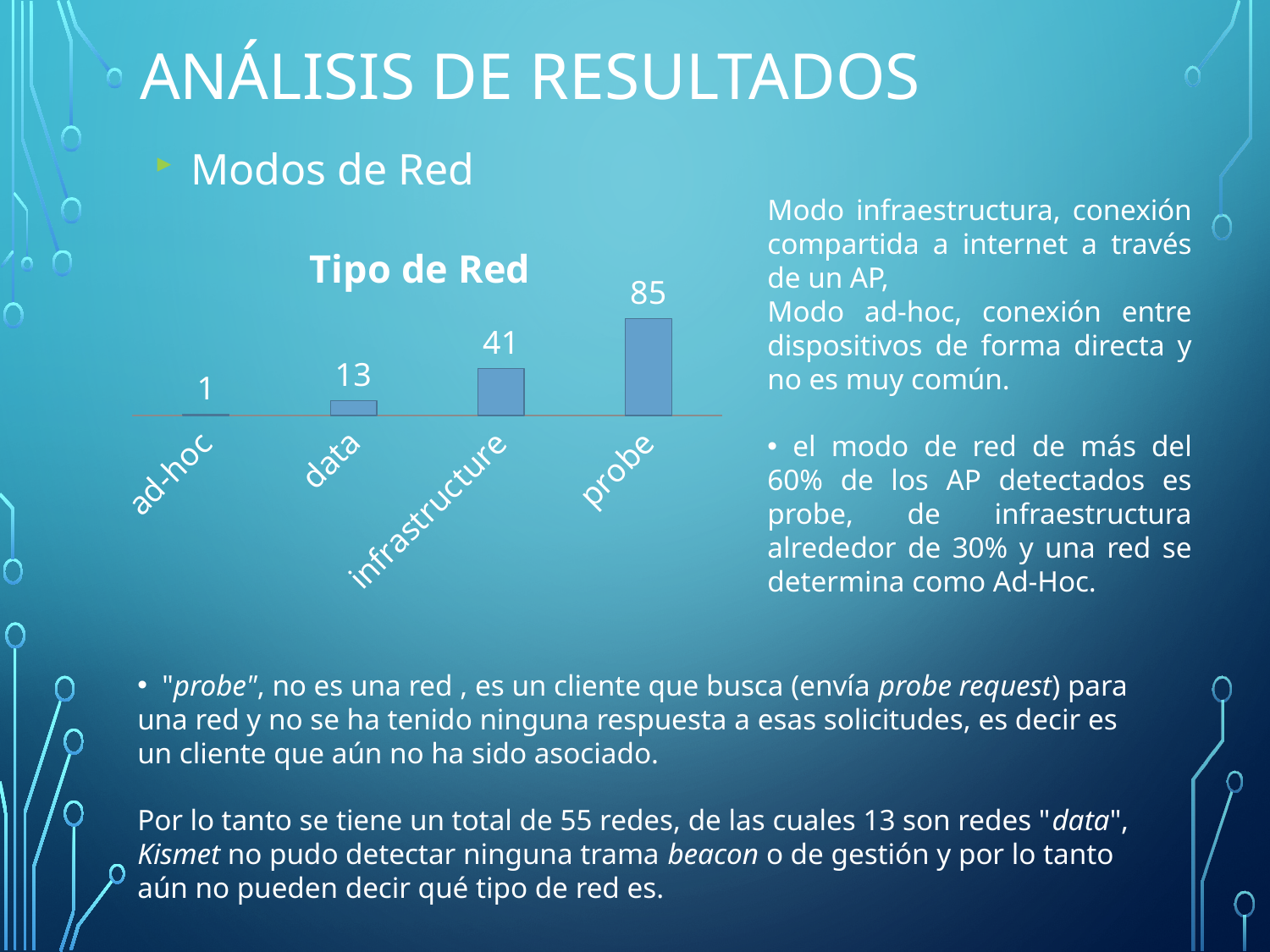
Which category has the highest value in the Tipo de Red chart? probe What is the value for infrastructure in the Tipo de Red chart? 41 What is the value for ad-hoc in the Tipo de Red chart? 1 What is the difference between the values for infrastructure and data in the Tipo de Red chart? 28 Which category has the lowest value in the Tipo de Red chart? ad-hoc How many categories are shown in the Tipo de Red chart? 4 What is the title of the chart on the slide? Tipo de Red What kind of chart is the Tipo de Red chart? bar chart What is the difference between the values for probe and infrastructure in the Tipo de Red chart? 44 What is the value for probe in the Tipo de Red chart? 85 Which is larger in the Tipo de Red chart, data or infrastructure? infrastructure What is the value for data in the Tipo de Red chart? 13